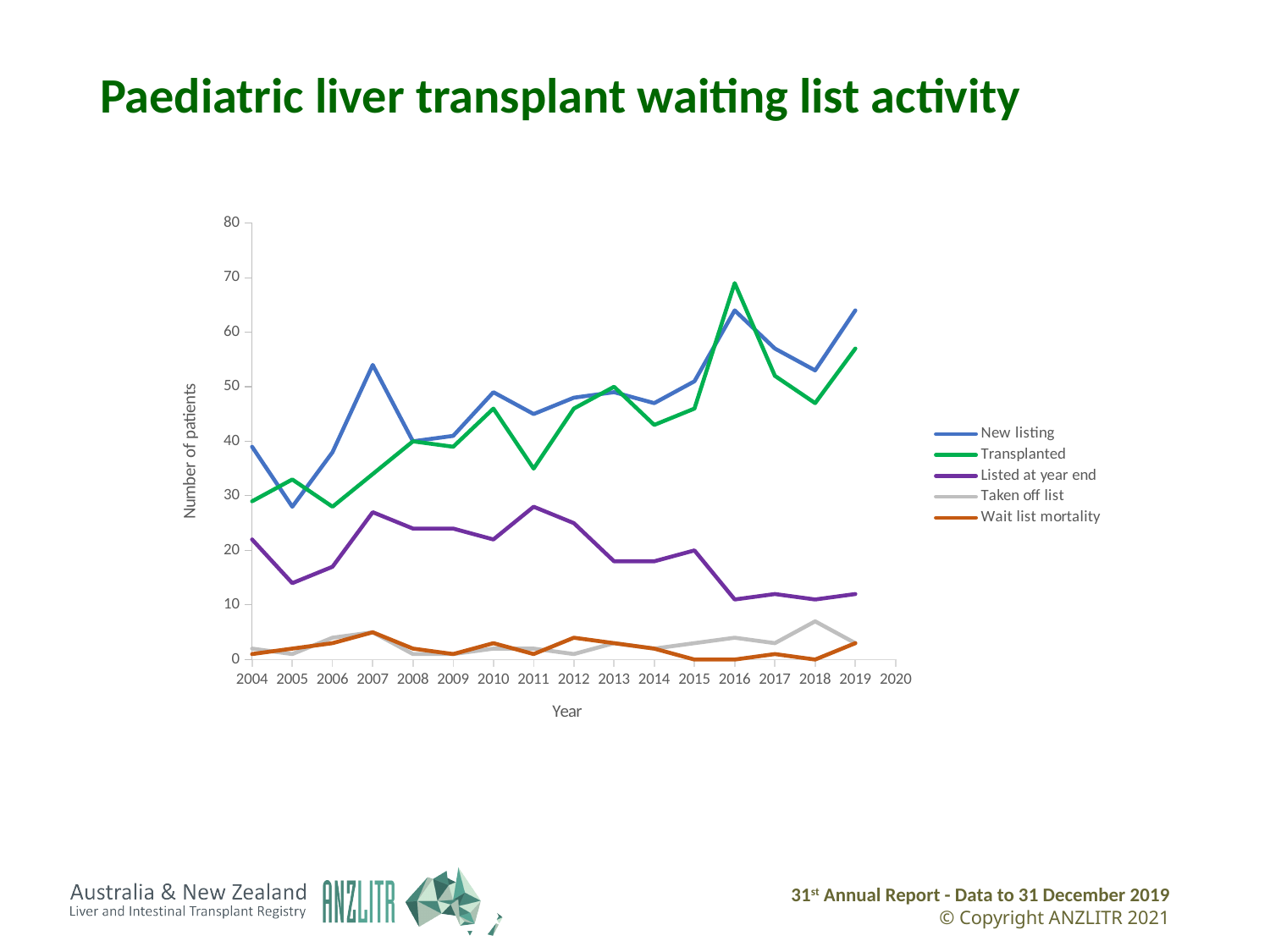
In which year does the Transplanted series reach its highest value? 2016 What is the label on the vertical axis? Number of patients Is the value for Listed at year end in 2016 greater or less than 20? less Is the value for Transplanted in 2011 greater or less than 40? less Is the value for New listing in 2007 greater or less than 50? greater Does the Listed at year end series rise or fall from 2015 to 2016? Fall Which series is drawn in purple? Listed at year end In 2016, which is higher: Transplanted or New listing? Transplanted In 2007, which is higher: New listing or Transplanted? New listing How many series does the legend list? 5 What kind of chart is shown on the slide? Line chart